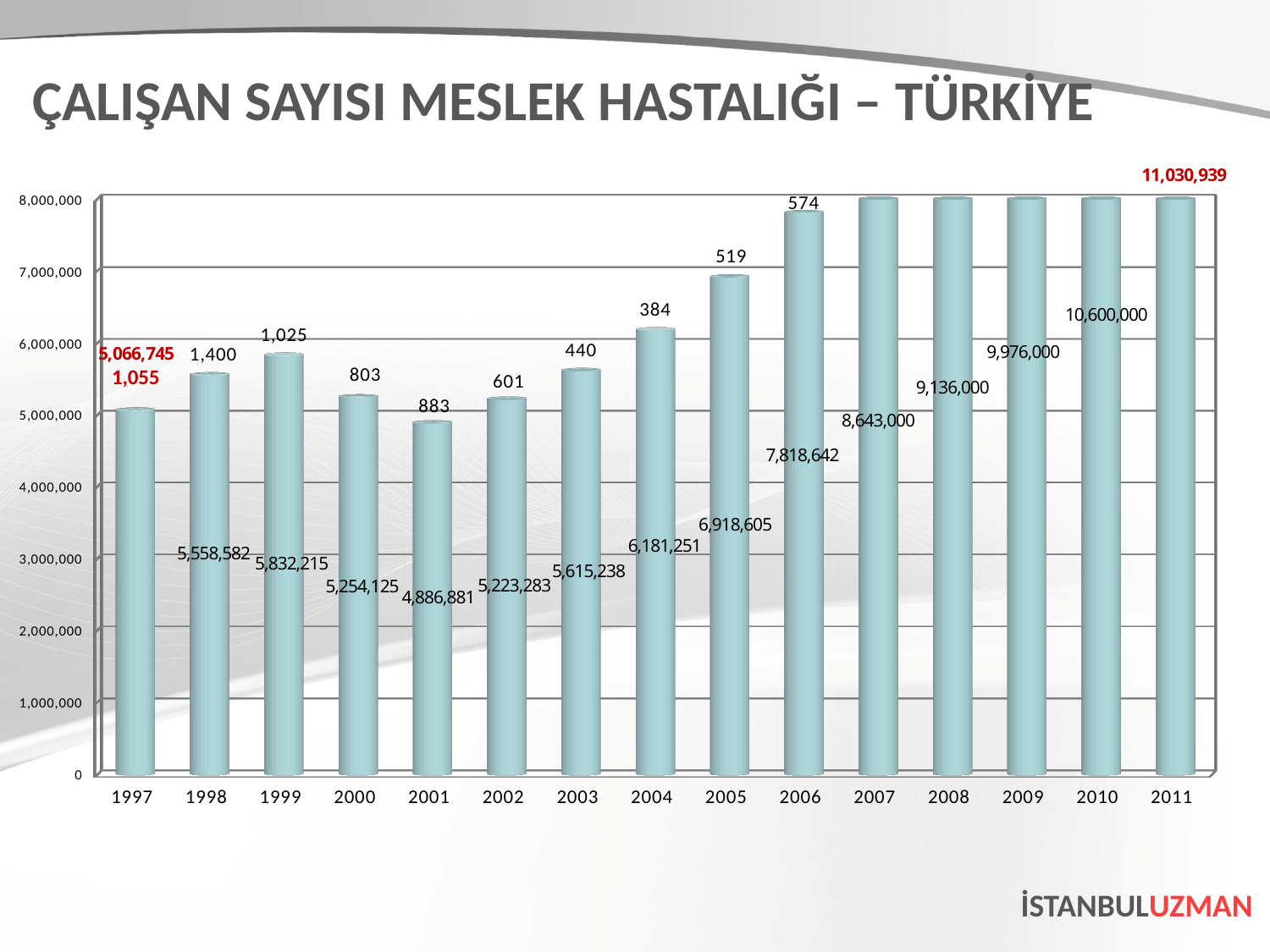
What is the number of workers shown for 2009? 9,976,000 Which year has the lowest number of workers? 2001 Which year has the highest number of workers? 2011 What is the difference in the number of workers between 2010 and 2009? 624,000 What is the number of workers shown for 2011? 11,030,939 Do the number of workers generally rise or fall from 2003 to 2011? rise What kind of chart is shown on the slide? bar chart How many years are shown on the x axis? 15 Is the value for 2005 greater or less than 7,000,000? less Which year has more workers, 1999 or 2000? 1999 What is the number of workers shown for 2001? 4,886,881 What is the number of workers shown for 2006? 7,818,642